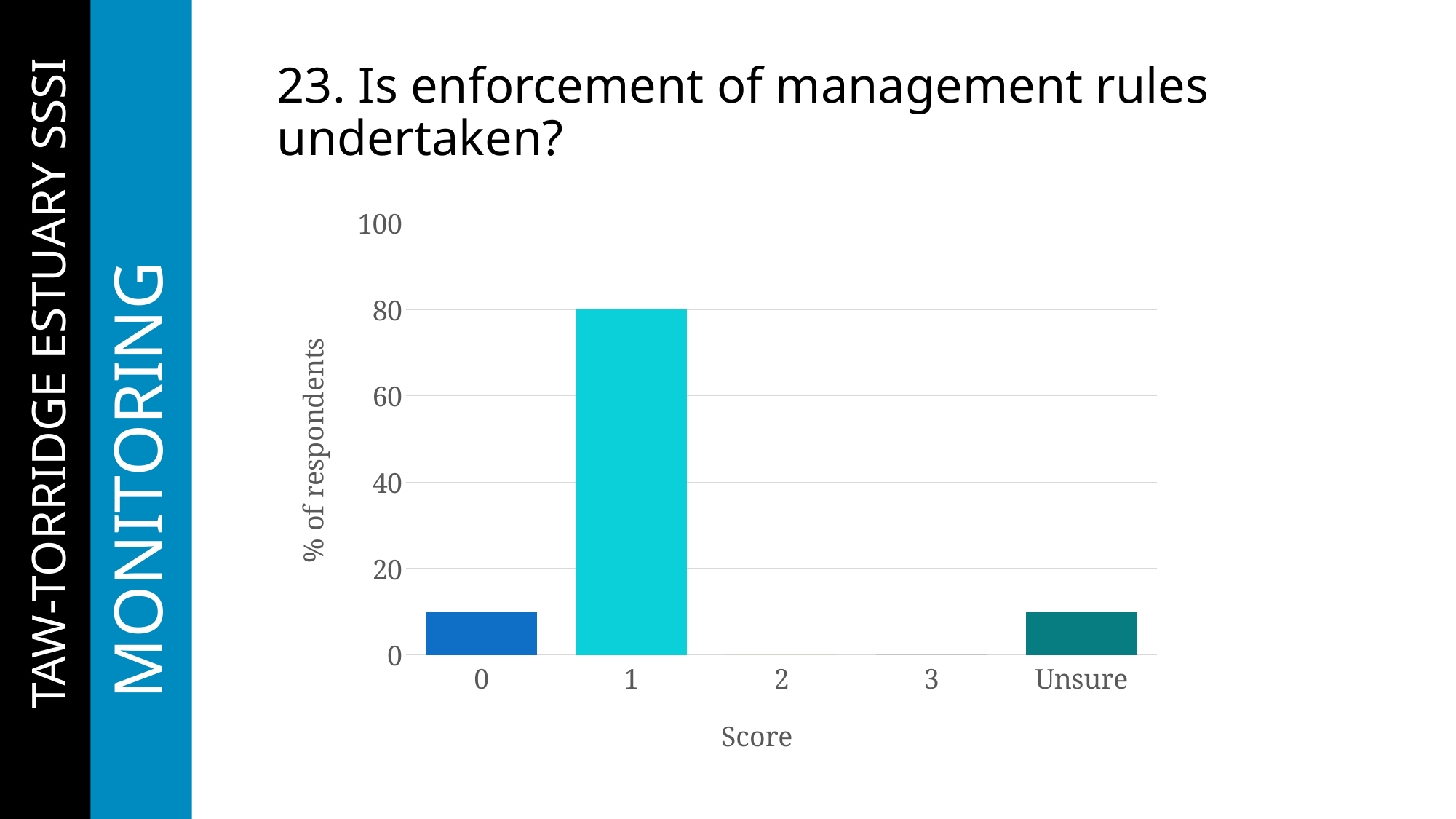
How many score categories have a value of 0? 2 What is the label on the x axis? Score What percentage of respondents gave a score of 2? 0 What percentage of respondents gave a score of 1? 80 Is the value for Unsure greater or less than 20? less Which score category has the highest percentage of respondents? 1 How many score categories are shown on the x axis? 5 What kind of chart is shown on the slide? bar chart Which has a larger value, score 1 or Unsure? 1 What is the label on the y axis? % of respondents Is the value for score 1 greater or less than 60? greater Is the value for score 0 greater or less than 20? less